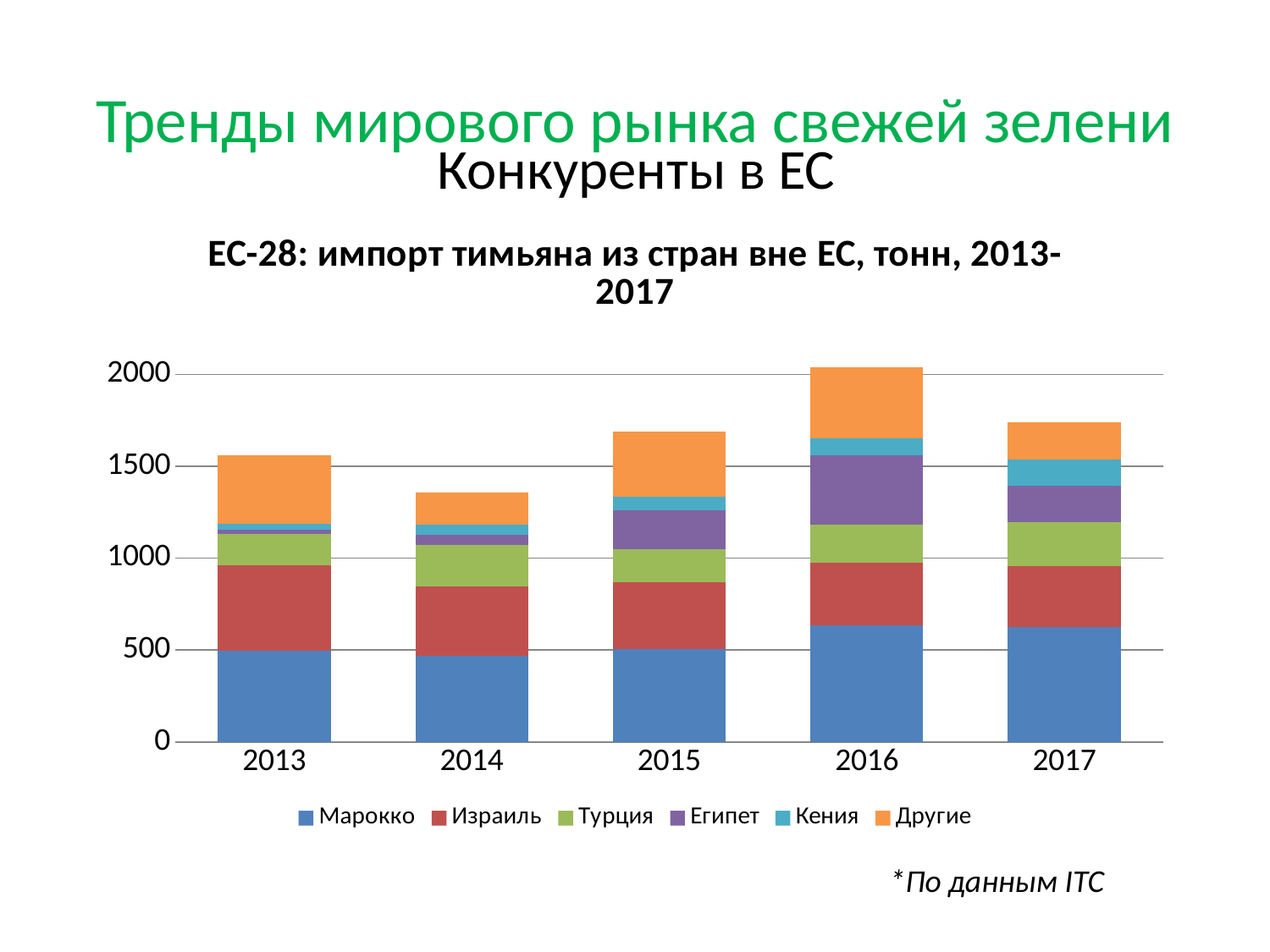
How many years are shown on the x axis? 5 Do the total imports rise or fall from 2014 to 2016? rise Which year has the larger total, 2013 or 2015? 2015 Is the value for Марокко in 2016 greater or less than 500? greater Which year has the lowest total import of thyme? 2014 Which country is listed first in the legend? Марокко Is the total for 2017 greater or less than 2000? less What kind of chart is shown on the slide? stacked bar chart Is the total for 2014 greater or less than 1500? less Which year has the highest total import of thyme? 2016 How many series does the legend list? 6